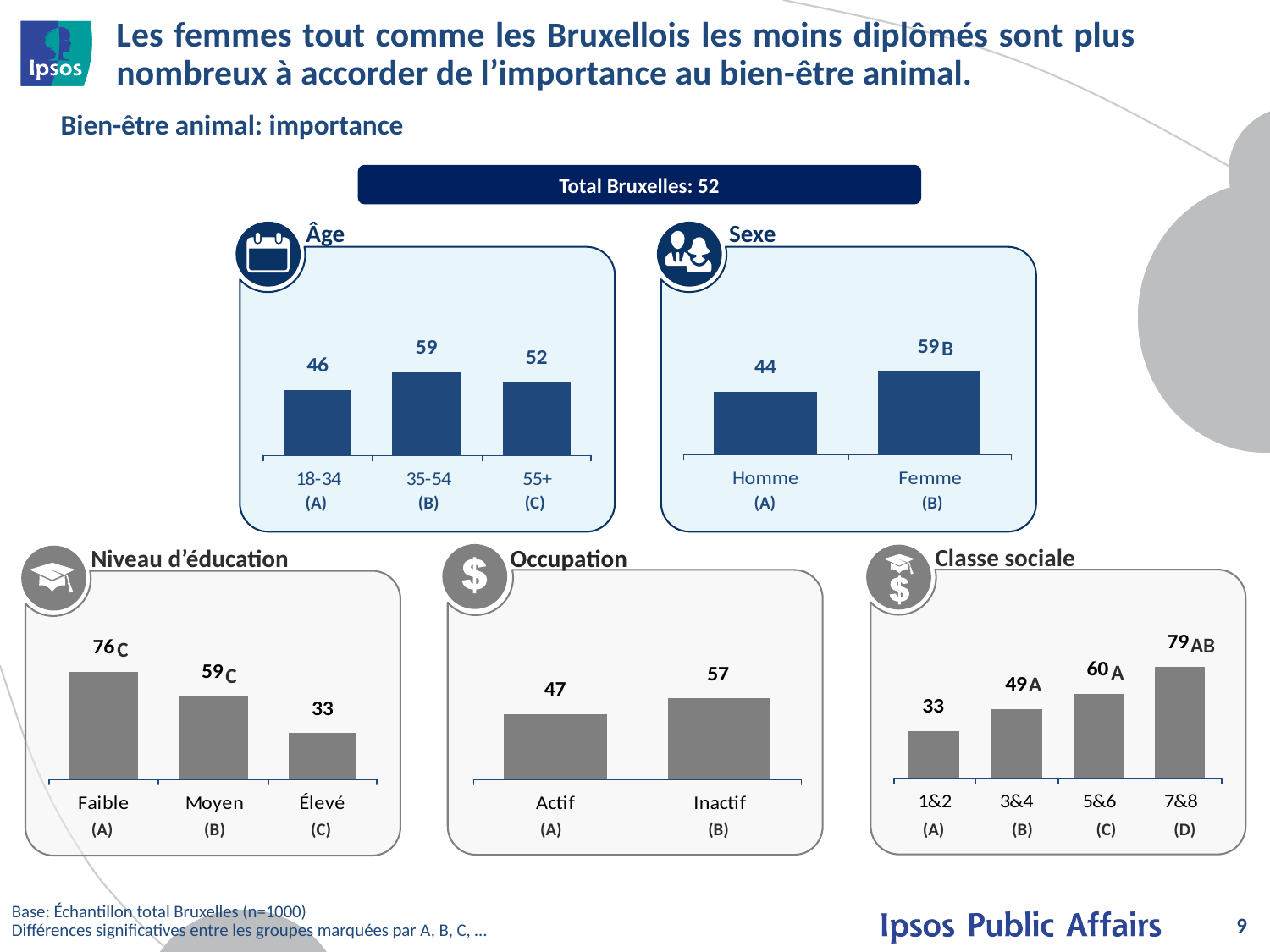
In the Sexe chart, what is the value for Femme? 59 In the Âge chart, which age group has the lowest value? 18-34 In the Classe sociale chart, do the values rise or fall from 1&2 to 7&8? rise In the Classe sociale chart, how many categories are shown? 4 In the Occupation chart, which is larger, the value for Actif or Inactif? Inactif In the Occupation chart, what is the value for Actif? 47 In the Âge chart, what is the value for the 35-54 group? 59 In the Sexe chart, what is the difference between the values for Femme and Homme? 15 In the Niveau d'éducation chart, what is the value for Élevé? 33 In the Niveau d'éducation chart, which category has the highest value? Faible What kind of chart is the Âge chart? bar chart In the Classe sociale chart, what is the value for the 7&8 group? 79